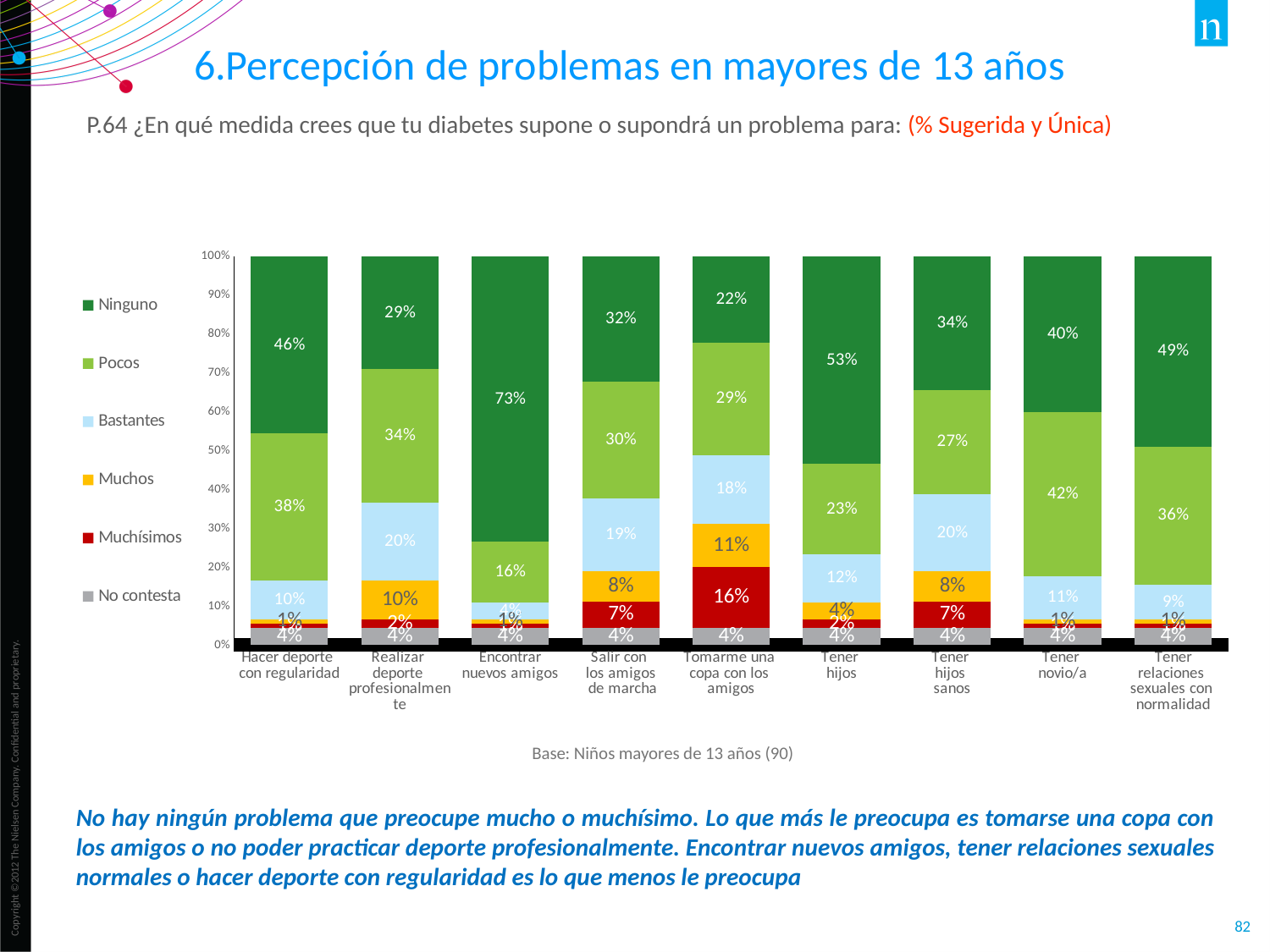
How many series does the legend list? 6 What is the difference in percentage points between the "Ninguno" value for "Encontrar nuevos amigos" and for "Tomarme una copa con los amigos"? 51 percentage points For "Tener novio/a", which is larger: the "Pocos" value or the "Ninguno" value? Pocos Which category has the highest "Ninguno" value? Encontrar nuevos amigos Which category has the highest "Muchísimos" value? Tomarme una copa con los amigos What percentage of respondents answered "Ninguno" for "Encontrar nuevos amigos"? 73% Which category has the lowest "Ninguno" value? Tomarme una copa con los amigos What is the "Pocos" value for "Tener novio/a"? 42% What is the "Bastantes" value for "Realizar deporte profesionalmente"? 20% What type of chart is shown on the slide? Stacked bar chart What is the "Muchísimos" value for "Tomarme una copa con los amigos"? 16% How many categories are shown on the x axis of the chart? 9